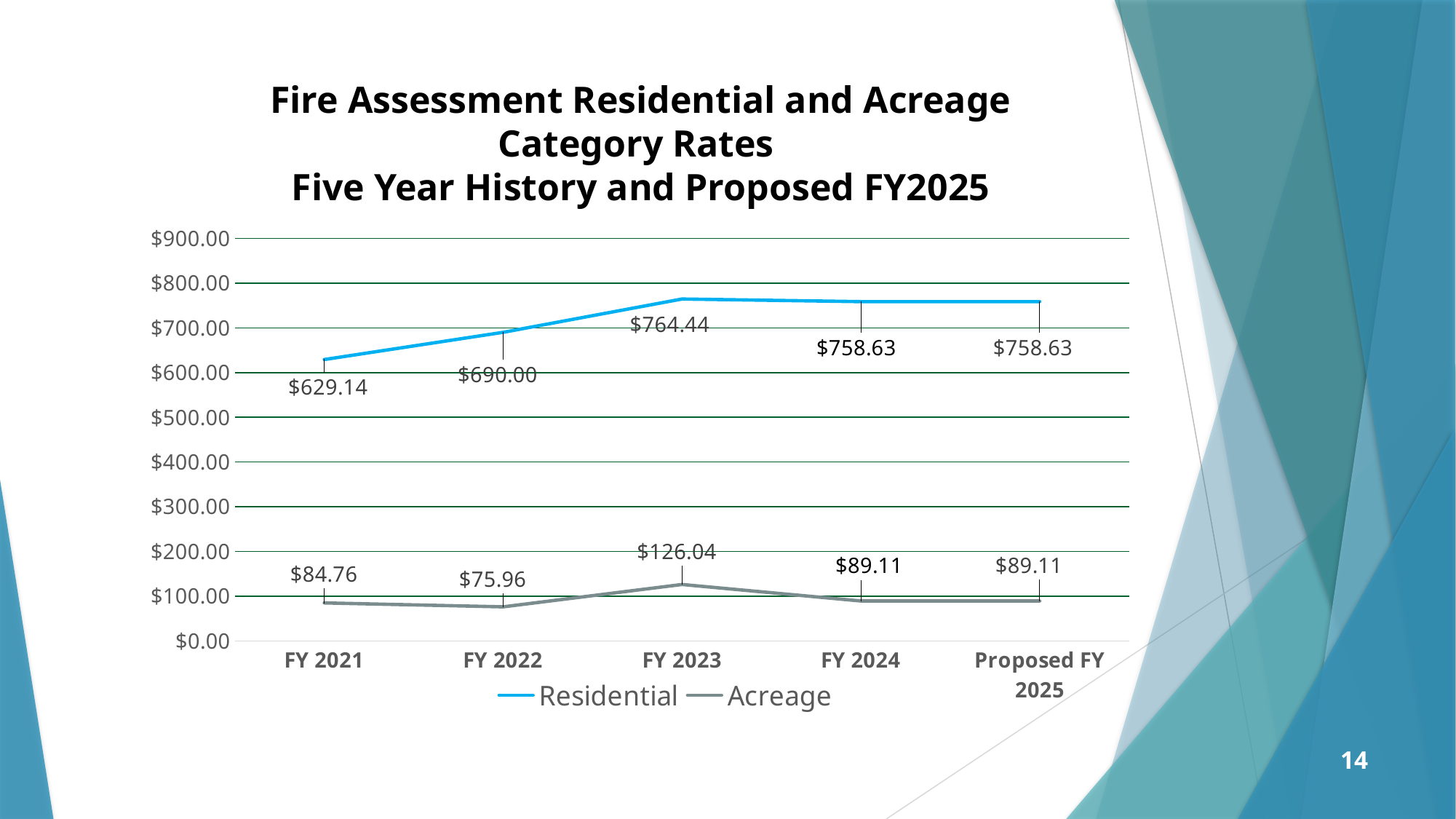
What is the Residential rate for FY 2021? $629.14 What is the difference between the Acreage rate in FY 2023 and FY 2022? $50.08 How many series does the legend list? 2 What is the Residential rate for Proposed FY 2025? $758.63 In which fiscal year is the Residential rate highest? FY 2023 What is the Acreage rate for FY 2022? $75.96 Which is larger, the Residential rate in FY 2022 or in FY 2021? FY 2022 What is the difference between the Residential rate in FY 2023 and FY 2022? $74.44 How many fiscal year categories are shown on the x axis? 5 What is the Acreage rate for FY 2023? $126.04 What kind of chart is shown on the slide? Line chart In which fiscal year is the Acreage rate lowest? FY 2022